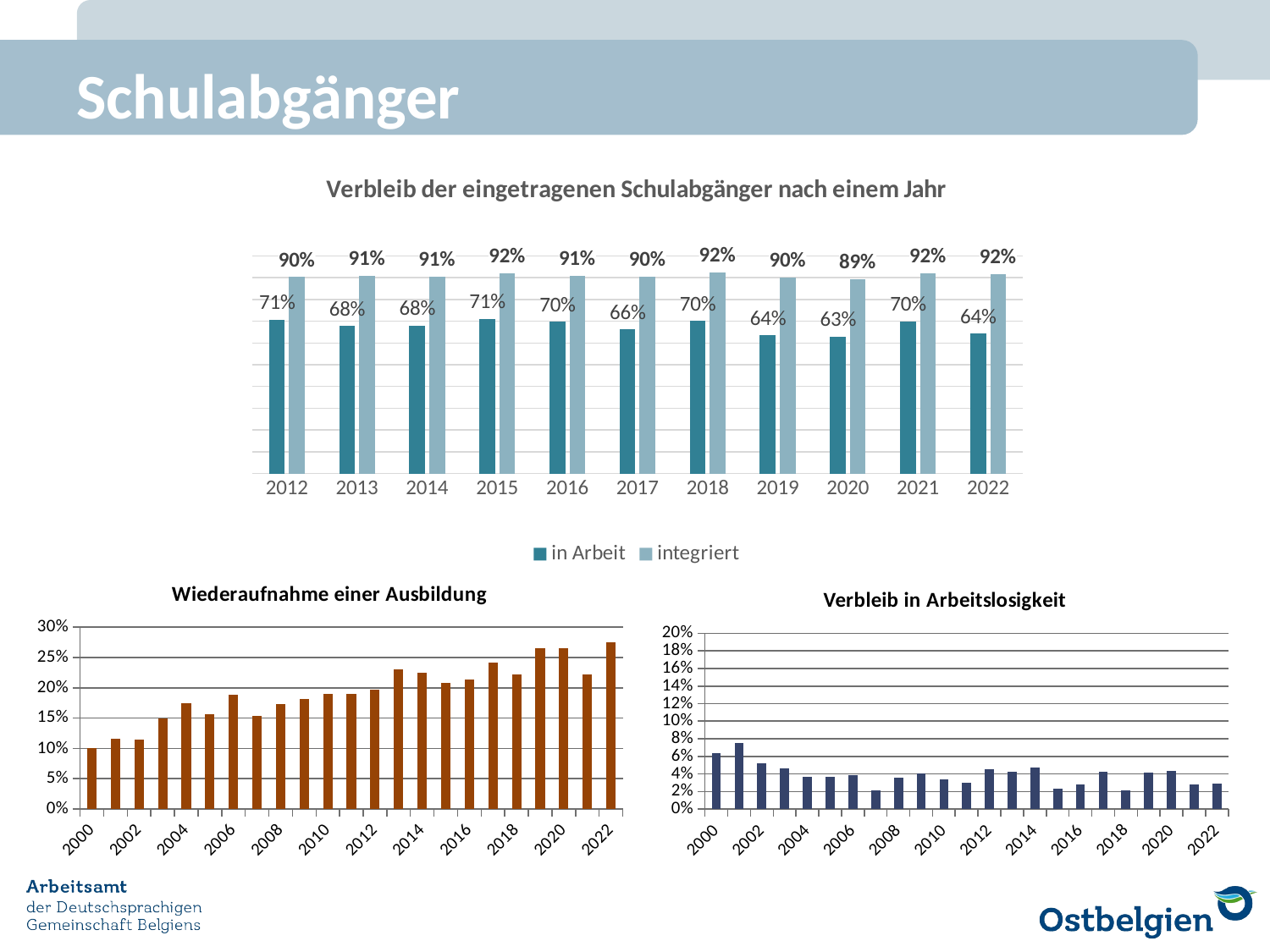
In the chart 'Verbleib der eingetragenen Schulabgänger nach einem Jahr', what is the value for 'integriert' in 2015? 92% In the chart 'Verbleib der eingetragenen Schulabgänger nach einem Jahr', which year has the higher value for 'in Arbeit', 2017 or 2019? 2017 In the chart 'Verbleib der eingetragenen Schulabgänger nach einem Jahr', what is the value for 'in Arbeit' in 2020? 63% What kind of chart is 'Wiederaufnahme einer Ausbildung'? bar chart In the chart 'Verbleib der eingetragenen Schulabgänger nach einem Jahr', which year has the lowest value for 'in Arbeit'? 2020 In the chart 'Wiederaufnahme einer Ausbildung', is the value for 2022 greater or less than 25%? greater How many years are shown on the x axis of the chart 'Verbleib der eingetragenen Schulabgänger nach einem Jahr'? 11 In the chart 'Verbleib in Arbeitslosigkeit', which year has the highest value? 2001 In the chart 'Verbleib der eingetragenen Schulabgänger nach einem Jahr', what is the difference between 'integriert' and 'in Arbeit' in 2022? 28% In the chart 'Verbleib der eingetragenen Schulabgänger nach einem Jahr', which year has the lowest value for 'integriert'? 2020 How many series does the legend of the chart 'Verbleib der eingetragenen Schulabgänger nach einem Jahr' list? 2 In the chart 'Wiederaufnahme einer Ausbildung', do the values generally rise or fall from 2000 to 2022? rise